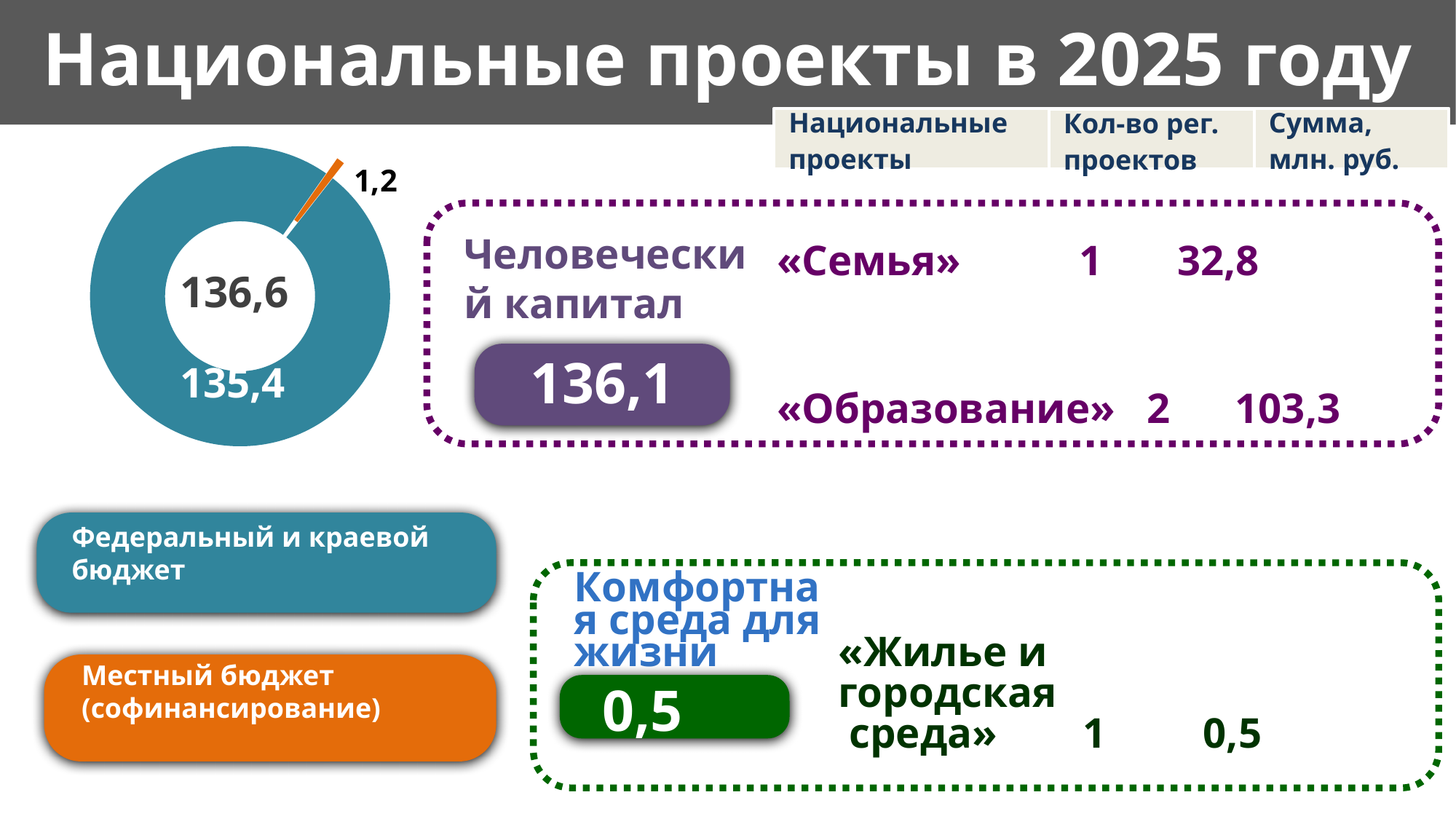
What value is shown for the Федеральный и краевой бюджет slice of the doughnut chart? 135,4 What total is shown in the centre of the doughnut chart? 136,6 How many slices does the doughnut chart have? 2 What colour is the Местный бюджет (софинансирование) slice of the doughnut chart? orange What value is shown for the Местный бюджет (софинансирование) slice of the doughnut chart? 1,2 Which is larger in the doughnut chart: Федеральный и краевой бюджет or Местный бюджет (софинансирование)? Федеральный и краевой бюджет What colour is the Федеральный и краевой бюджет slice of the doughnut chart? teal Which slice of the doughnut chart is the smallest? Местный бюджет (софинансирование) What is the difference between the Федеральный и краевой бюджет value and the Местный бюджет (софинансирование) value in the doughnut chart? 134,2 Which slice of the doughnut chart is the largest? Федеральный и краевой бюджет What kind of chart is shown on the left of the slide? doughnut chart